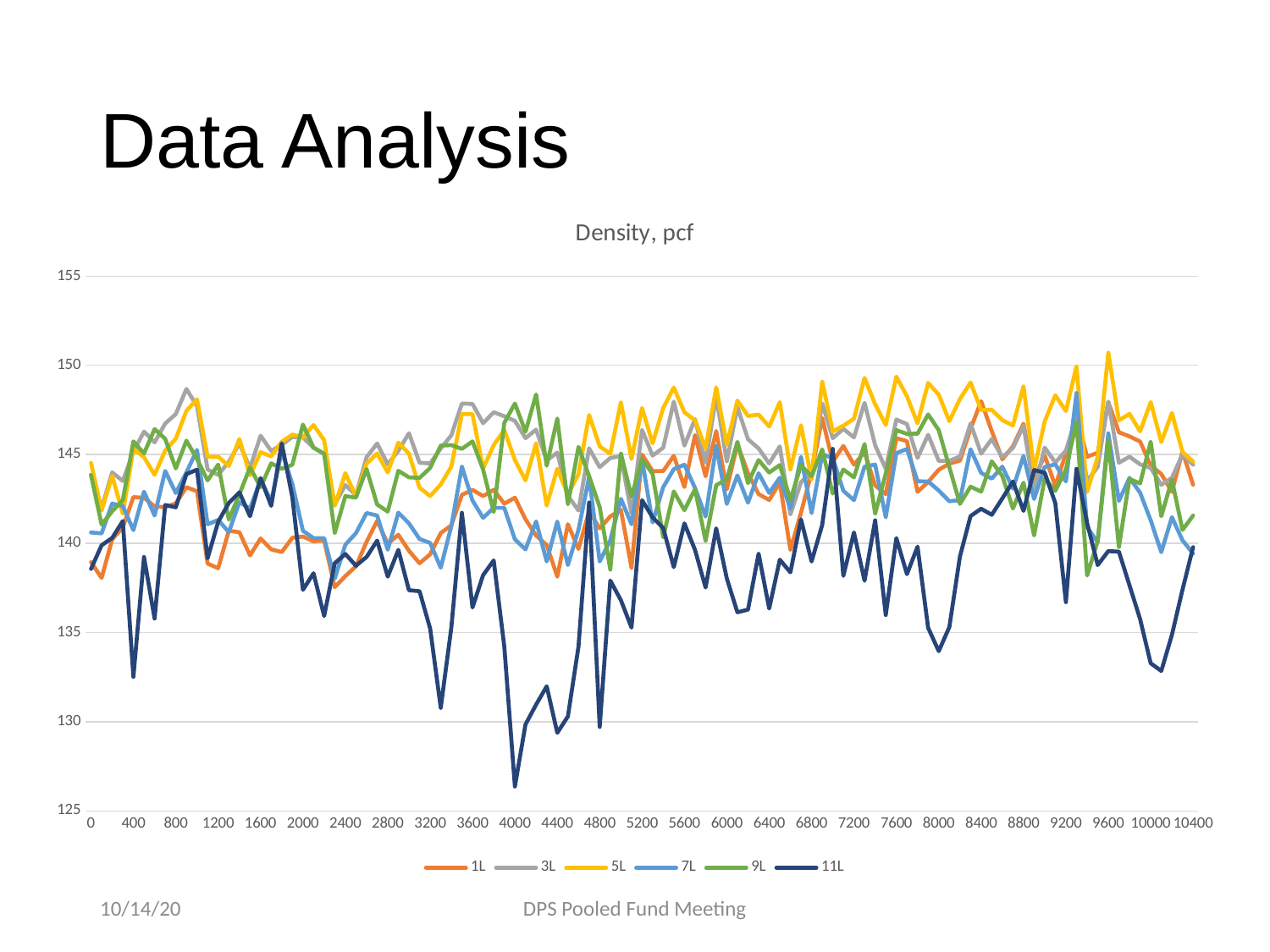
Is the value for 11L at x = 4000 greater or less than 130? less At x = 4000, which series has the larger value, 5L or 11L? 5L Which series reaches the highest value anywhere on the chart? 5L Which series reaches the lowest value anywhere on the chart? 11L Is the value for 3L at x = 800 greater or less than 145? greater Which series are listed in the legend? 1L, 3L, 5L, 7L, 9L, 11L What is the title of the chart? Density, pcf At x = 400, which series has the larger value, 1L or 11L? 1L Does the 11L series rise or fall between x = 3600 and x = 4000? fall Is the value for 11L at x = 400 greater or less than 135? less What kind of chart is shown on the slide? line chart How many series does the legend list? 6